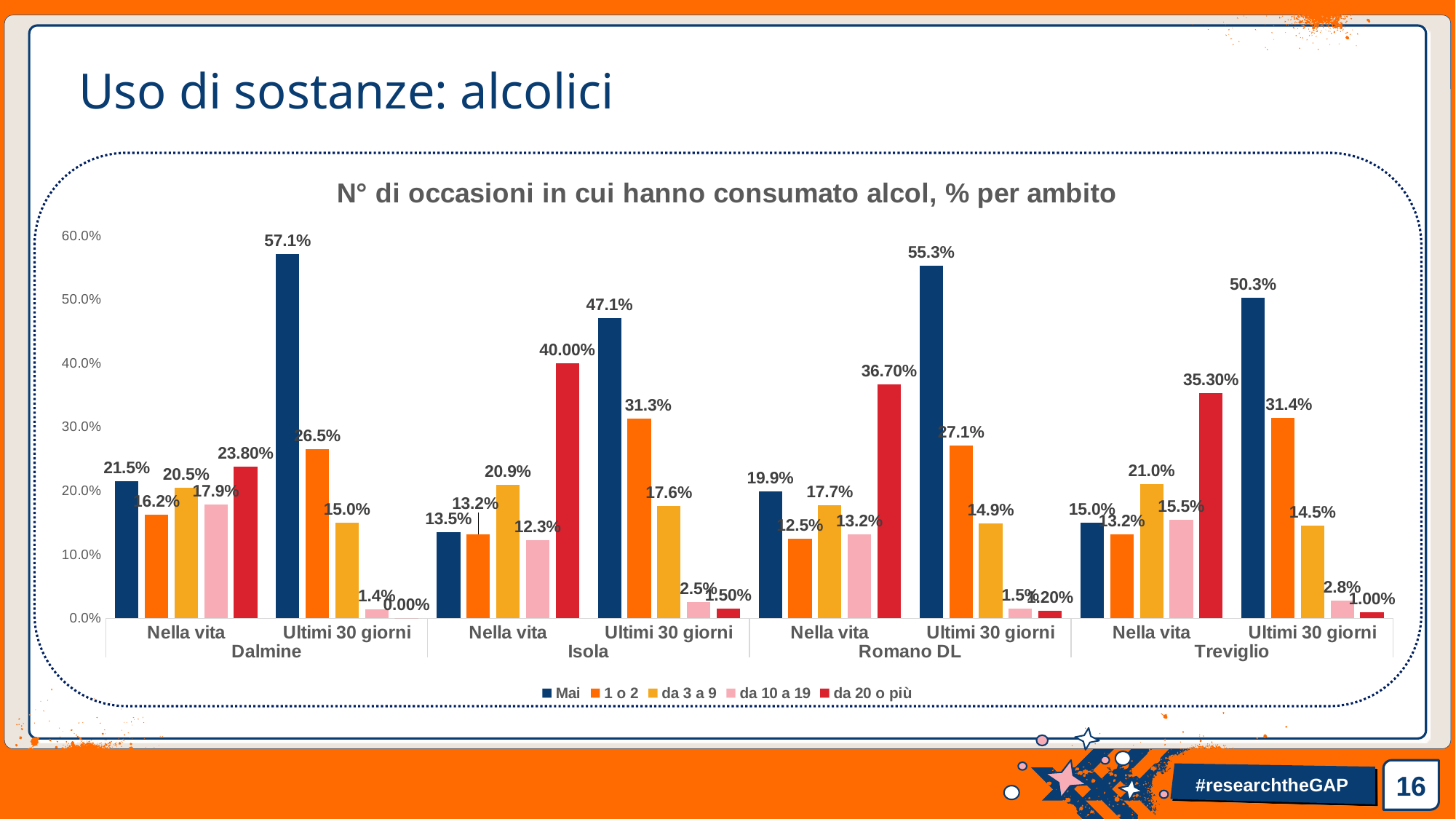
What is the title of the chart? N° di occasioni in cui hanno consumato alcol, % per ambito What is the value of '1 o 2' for Treviglio, Ultimi 30 giorni? 31.4% Which series has the lowest value for Dalmine, Ultimi 30 giorni? da 20 o più What is the difference between the 'Mai' values for Dalmine, Ultimi 30 giorni and Isola, Ultimi 30 giorni? 10.0% Which series has the highest value for Romano DL, Ultimi 30 giorni? Mai What is the value of 'da 20 o più' for Isola, Nella vita? 40.00% Is the value of 'Mai' for Treviglio, Ultimi 30 giorni greater or less than 40.0%? greater What is the value of 'da 10 a 19' for Romano DL, Nella vita? 13.2% How many series does the legend list? 5 What is the value of 'Mai' for Dalmine, Ultimi 30 giorni? 57.1% What type of chart is shown on the slide? bar chart Which is larger: 'da 20 o più' for Romano DL, Nella vita or 'da 20 o più' for Treviglio, Nella vita? Romano DL, Nella vita